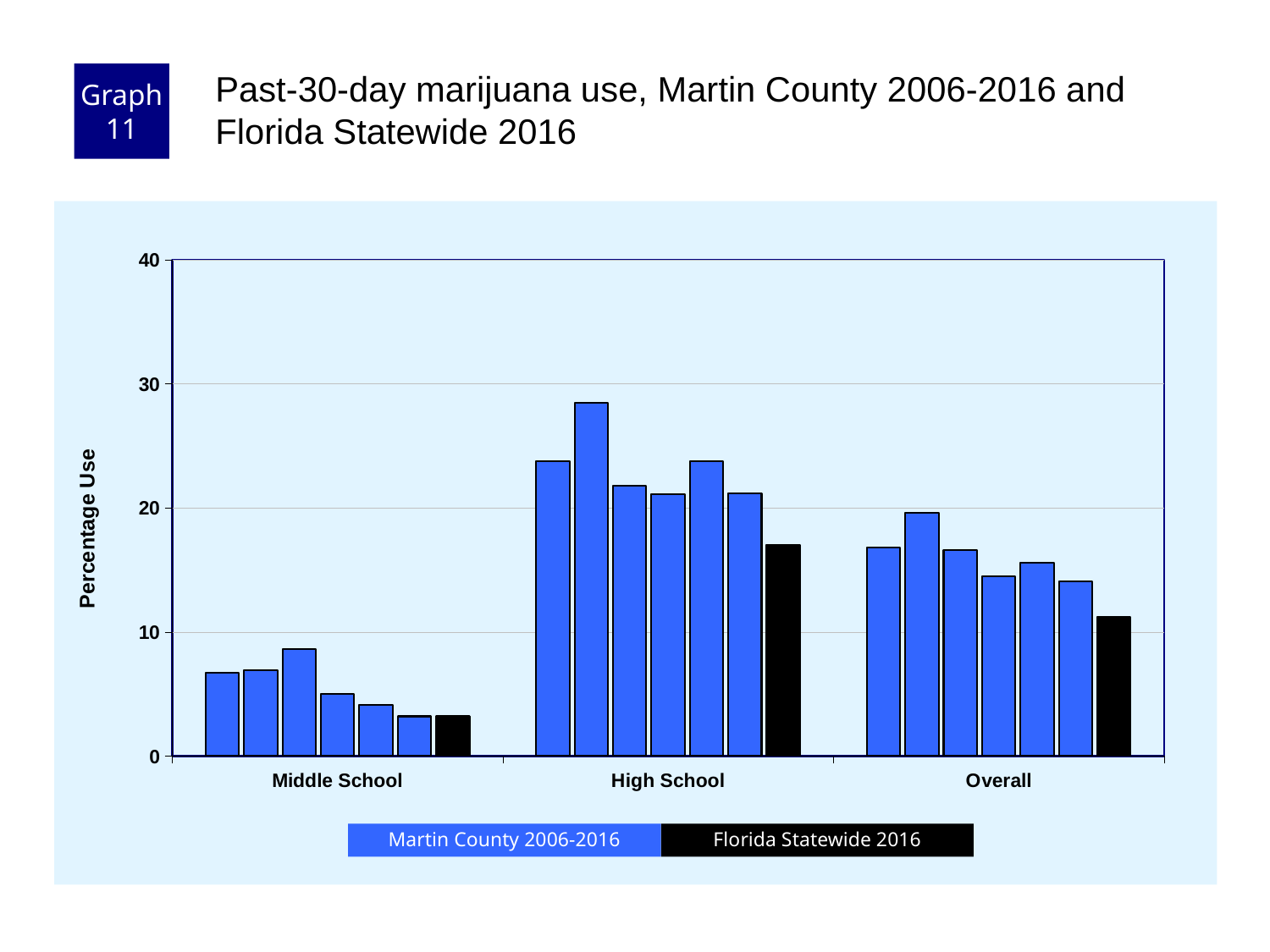
Which is larger: the Florida Statewide 2016 value for High School or for Overall? High School How many series does the legend list? 2 Do the Martin County bars for Middle School end higher or lower than they start? lower How many categories are shown on the x axis? 3 What colour are the Florida Statewide 2016 bars? black Is the Florida Statewide 2016 value for High School greater or less than 20? less Is the tallest Martin County bar for High School greater or less than 30? less Is the Florida Statewide 2016 value for Overall greater or less than 20? less Which category has the highest bars? High School Which category has the lowest bars? Middle School What kind of chart is shown on the slide? bar chart